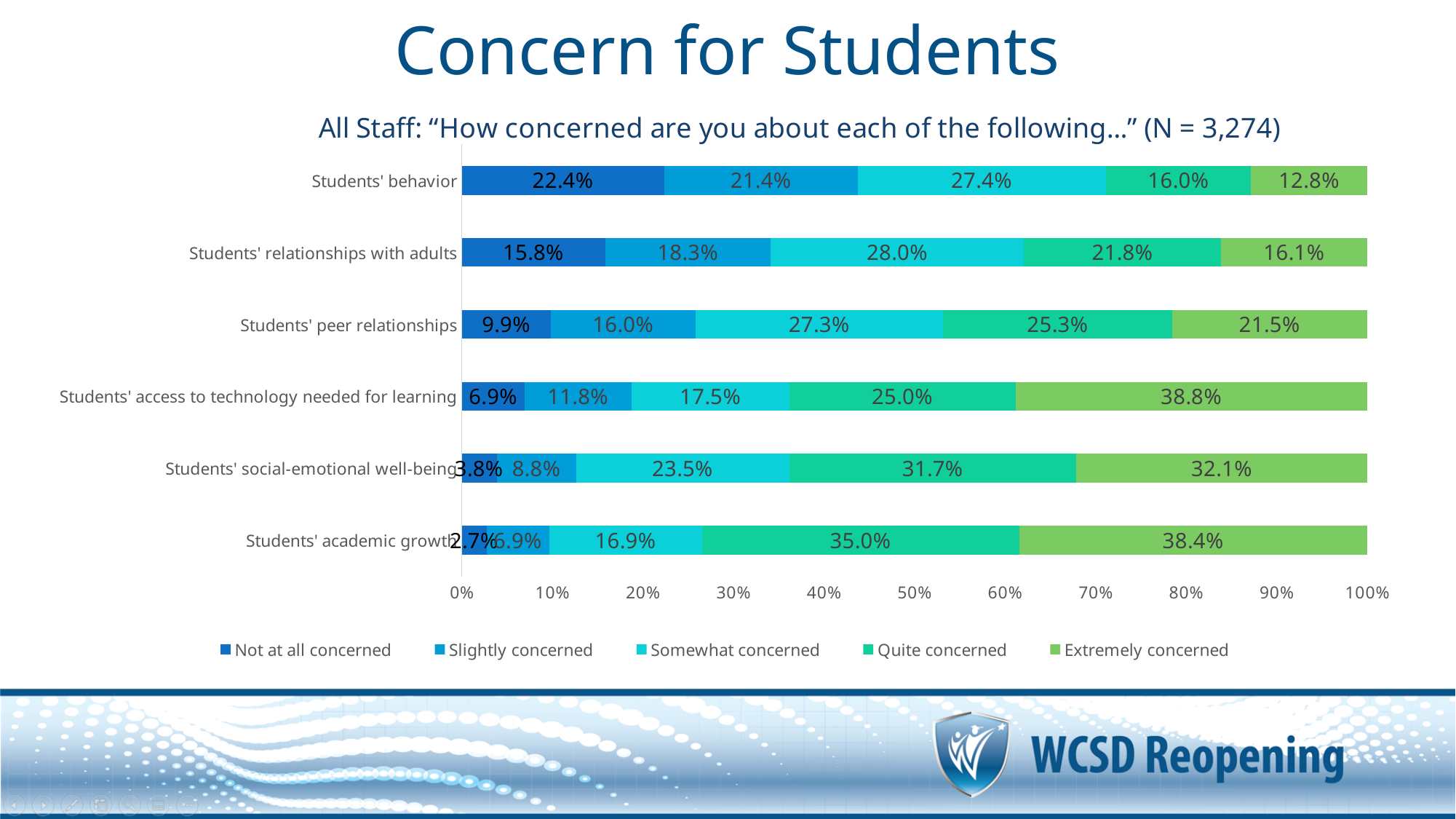
What percentage of staff were not at all concerned about students' behavior? 22.4% Which category has the highest 'Extremely concerned' percentage? Students' access to technology needed for learning According to the chart title, how many staff responded (N)? 3,274 How many categories (concern items) are shown in the chart? 6 How many series does the legend list? 5 Which category has the lowest 'Not at all concerned' percentage? Students' academic growth Which has a larger 'Quite concerned' percentage: students' social-emotional well-being or students' relationships with adults? Students' social-emotional well-being What percentage of staff were slightly concerned about students' peer relationships? 16.0% What kind of chart is shown on the slide? Stacked bar chart What percentage of staff were extremely concerned about students' access to technology needed for learning? 38.8% What is the total of the stacked bar for students' behavior? 100.0% How many percentage points higher is the 'Quite concerned' value for students' academic growth than for students' behavior? 19.0 percentage points